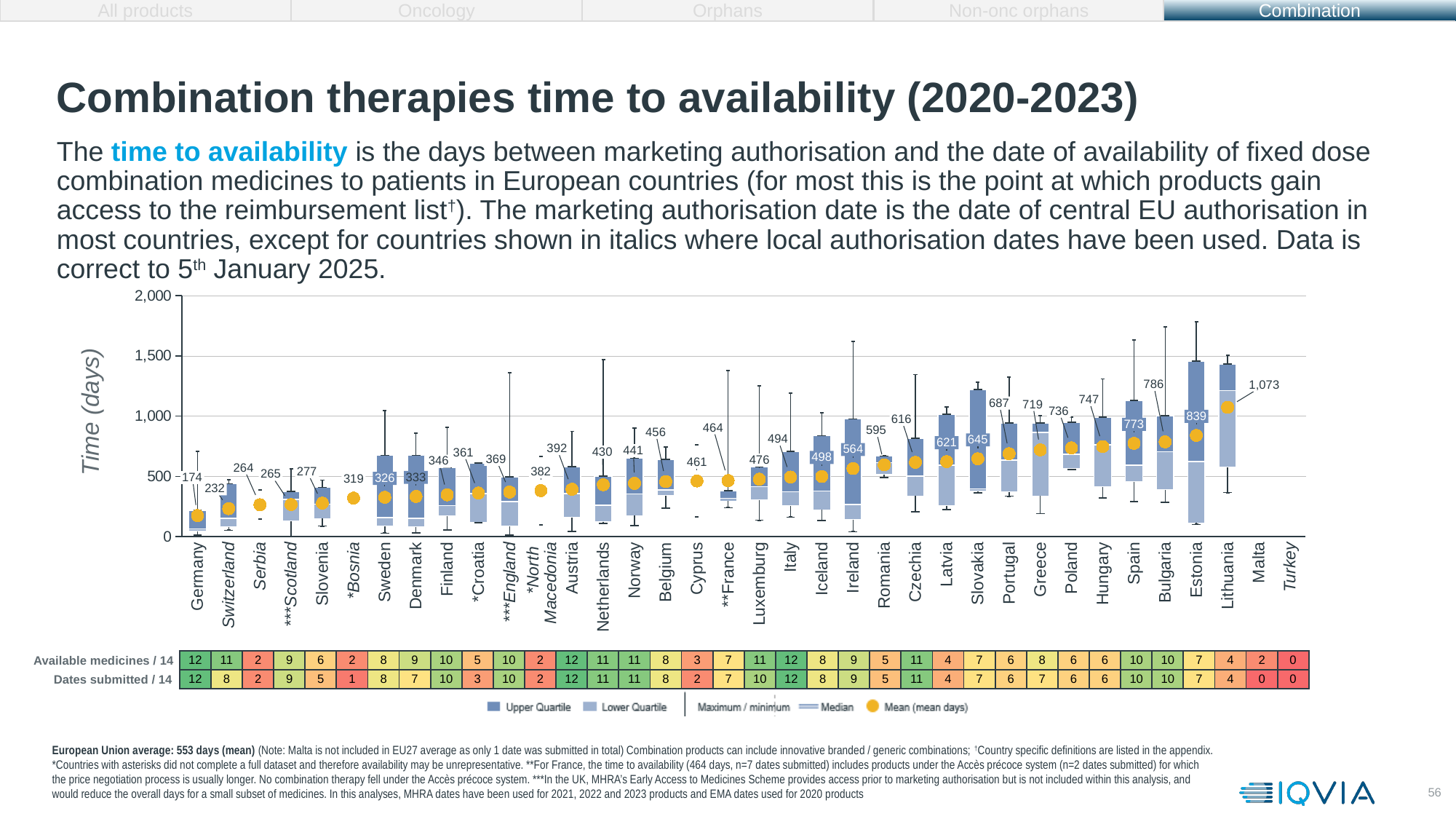
Which country has the highest labelled mean time to availability? Lithuania What is the mean time to availability (days) shown for Lithuania? 1,073 What is the mean time to availability (days) shown for Slovakia? 645 Which has a higher mean time to availability, Spain or Poland? Spain Which country has the lowest labelled mean time to availability? Germany What is the difference between the mean time to availability for Lithuania and for Germany? 899 What is the mean time to availability (days) shown for France? 464 Do the mean values generally rise or fall moving from left to right along the x axis? rise What kind of chart is used to show time to availability by country? Box plot What is the mean time to availability (days) shown for Germany? 174 What is the label on the y axis of the chart? Time (days)